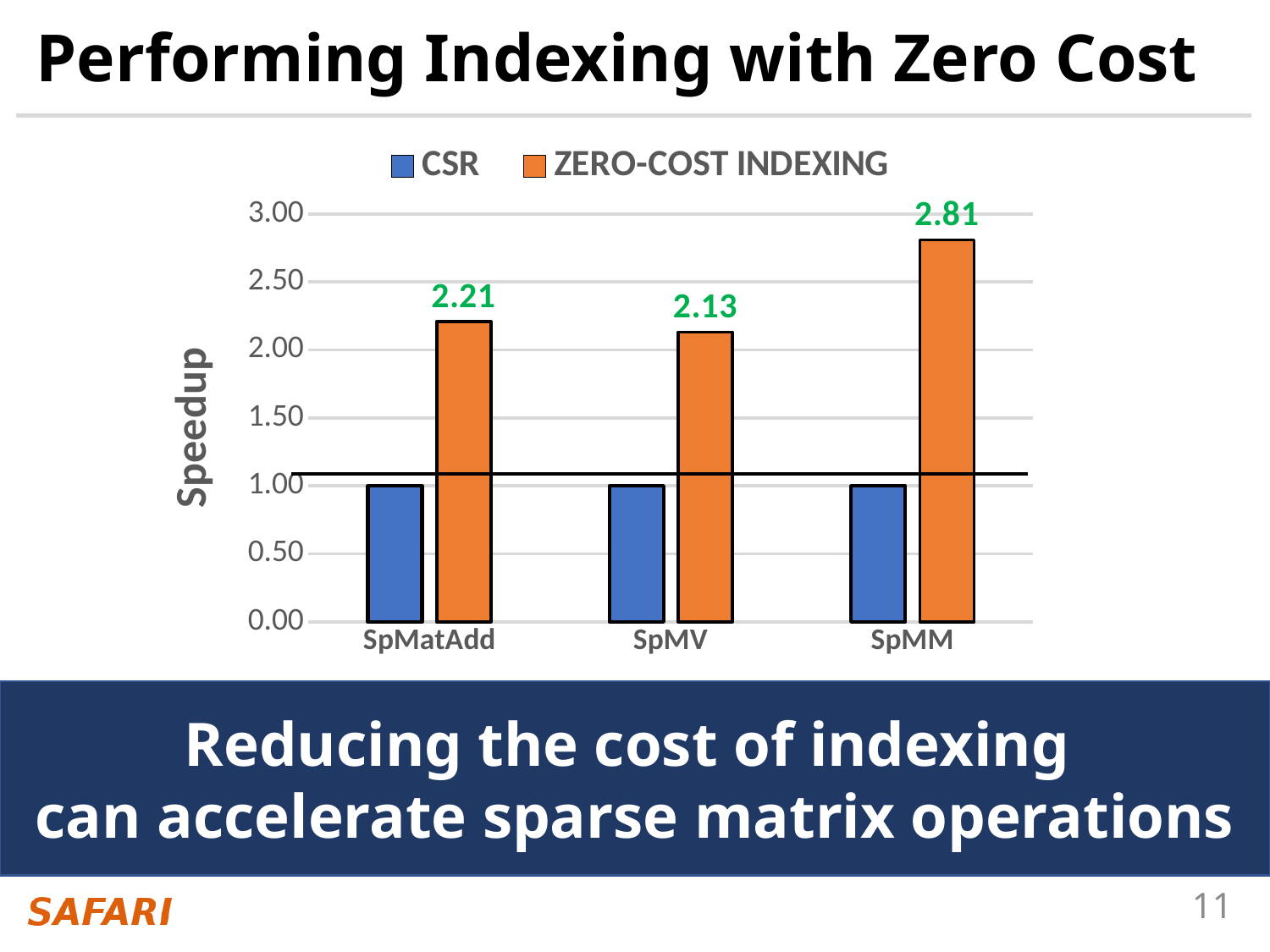
What is the difference between the ZERO-COST INDEXING speedups for SpMM and SpMV? 0.68 Is the ZERO-COST INDEXING speedup for SpMatAdd greater or less than 2.00? greater What is the speedup of ZERO-COST INDEXING for SpMM? 2.81 Which operation has the lowest ZERO-COST INDEXING speedup? SpMV Which operation has the highest ZERO-COST INDEXING speedup? SpMM How many series does the legend list? 2 What is the speedup of ZERO-COST INDEXING for SpMatAdd? 2.21 What is the difference between the ZERO-COST INDEXING speedups for SpMM and SpMatAdd? 0.60 What is the speedup of ZERO-COST INDEXING for SpMV? 2.13 What kind of chart is shown on the slide? bar chart How many operations (categories) are shown on the x axis? 3 Is the ZERO-COST INDEXING speedup for SpMM greater or less than 2.50? greater